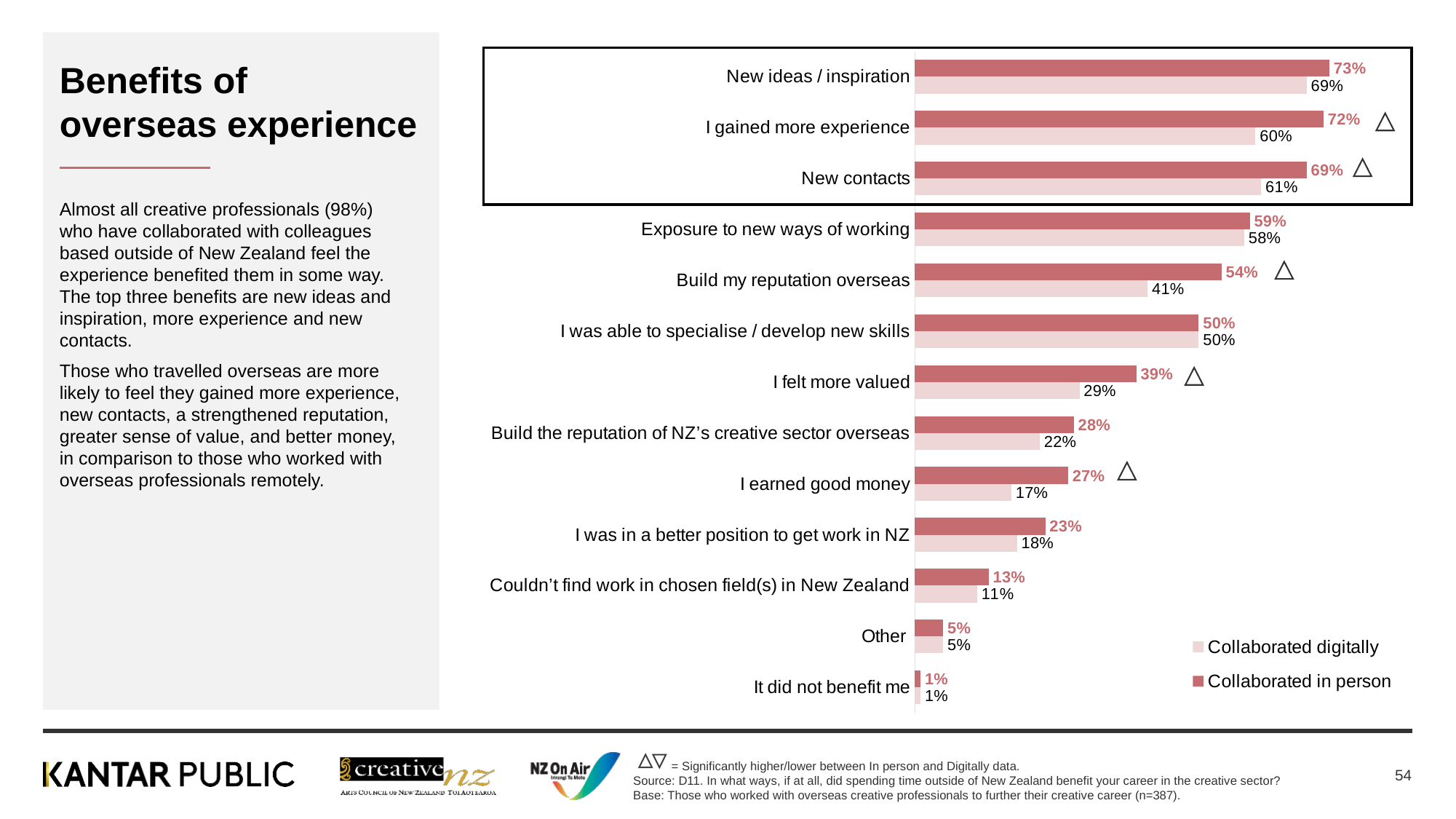
What is the value for 'Build my reputation overseas' among those who collaborated digitally? 41% What is the difference between the in-person and digital values for 'I gained more experience'? 12 percentage points How many benefit categories are shown in the chart? 13 What type of chart is shown on the slide? Bar chart Which benefit has the highest value for those who collaborated in person? New ideas / inspiration What is the difference between the in-person and digital values for 'Build my reputation overseas'? 13 percentage points Which benefit has the lowest value for those who collaborated digitally? It did not benefit me Which series is shown in the darker red colour? Collaborated in person What is the value for 'I earned good money' among those who collaborated in person? 27% What percentage of those who collaborated in person said they gained new ideas / inspiration? 73% How many series does the legend list? 2 For 'I felt more valued', which group has the larger value: collaborated in person or collaborated digitally? Collaborated in person